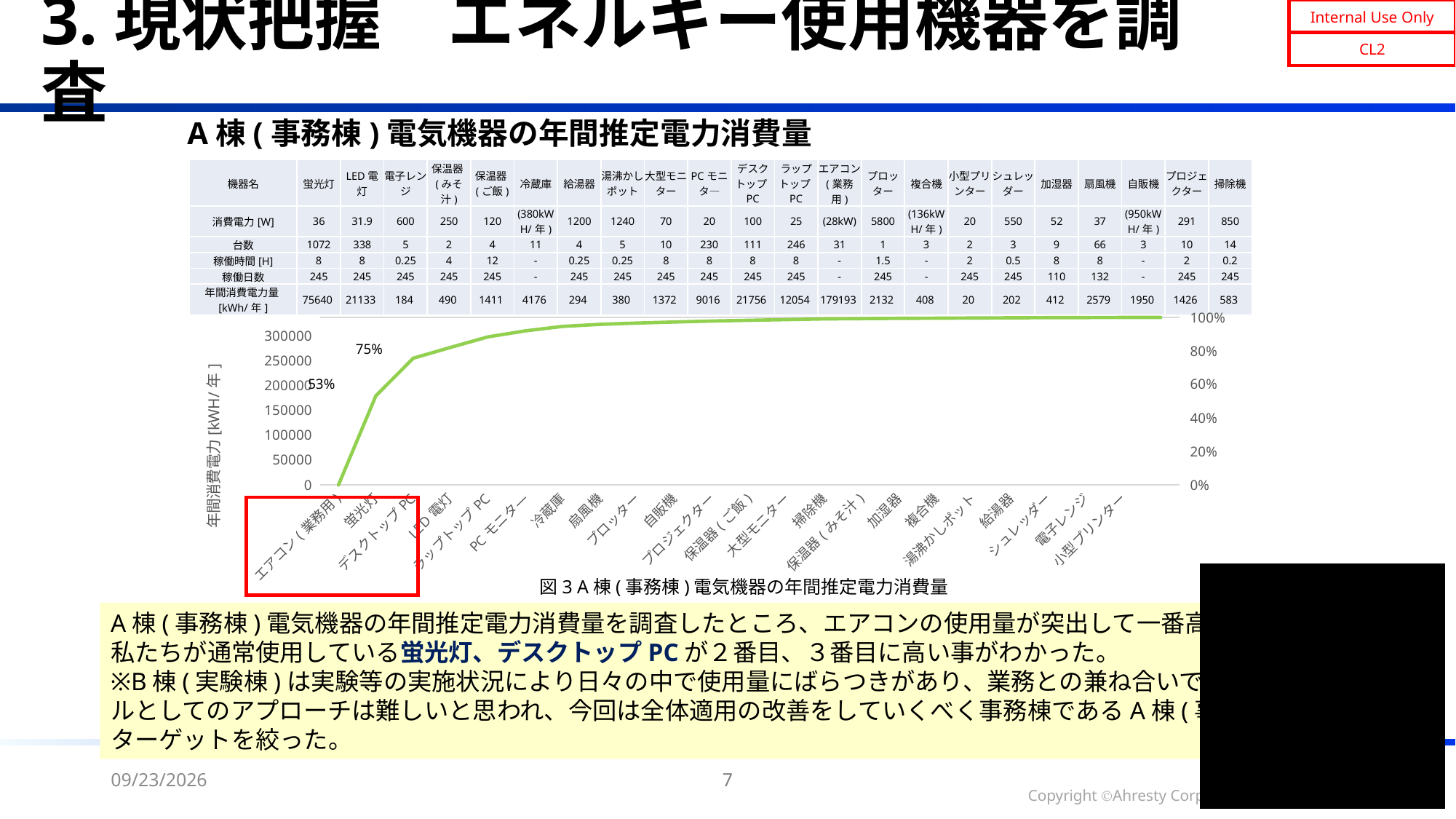
Which category appears last on the x axis of the chart? 小型プリンター What is the label of the left vertical axis of the chart? 年間消費電力 [kWH/年] What is the difference between the labelled cumulative percentages at デスクトップPC and 蛍光灯? 22 percentage points What kind of chart is shown on the slide? line chart Is the cumulative percentage at 蛍光灯 greater or less than 40%? greater What cumulative percentage is labelled at 蛍光灯 on the chart? 53% How many categories are listed along the x axis of the chart? 22 What cumulative percentage is labelled at デスクトップPC on the chart? 75% What is the caption shown below the chart? 図3 A棟(事務棟)電気機器の年間推定電力消費量 Is the cumulative percentage at PCモニター greater or less than 80%? greater Does the cumulative percentage line rise or fall from left to right along the x axis? rises Which category appears first on the x axis of the chart? エアコン(業務用)